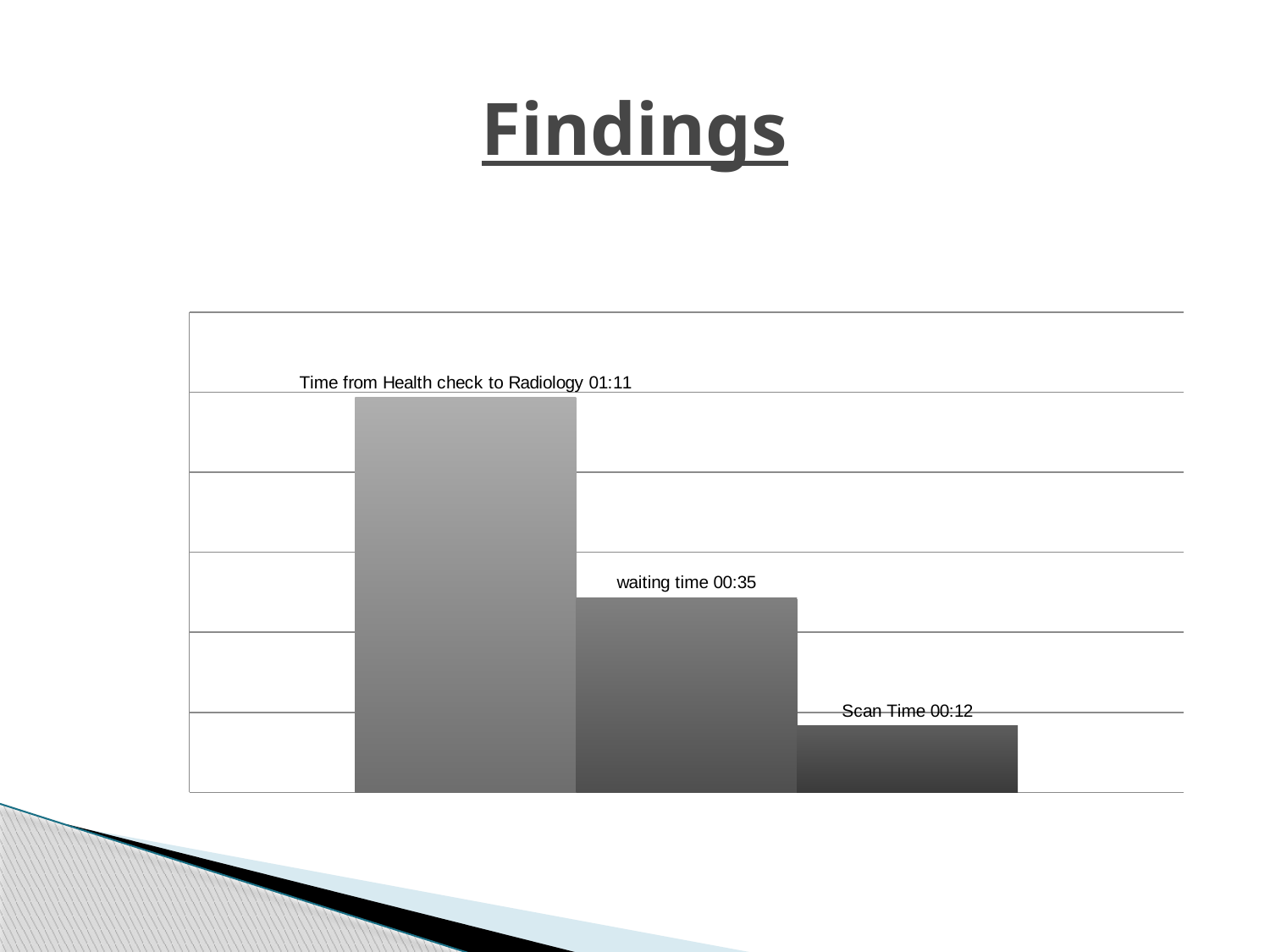
What is the value shown for Time from Health check to Radiology? 01:11 How many bars are plotted in the chart? 3 Which category has the highest value in the chart? Time from Health check to Radiology Which category has the lowest value in the chart? Scan Time Which is larger, waiting time or Scan Time? waiting time What is the value shown for Scan Time? 00:12 What is the difference between waiting time (00:35) and Scan Time (00:12)? 00:23 What is the difference between Time from Health check to Radiology (01:11) and waiting time (00:35)? 00:36 What is the title of the slide containing the chart? Findings What is the value shown for waiting time? 00:35 Do the bar values rise or fall from left to right across the chart? fall What kind of chart is shown on the slide? bar chart